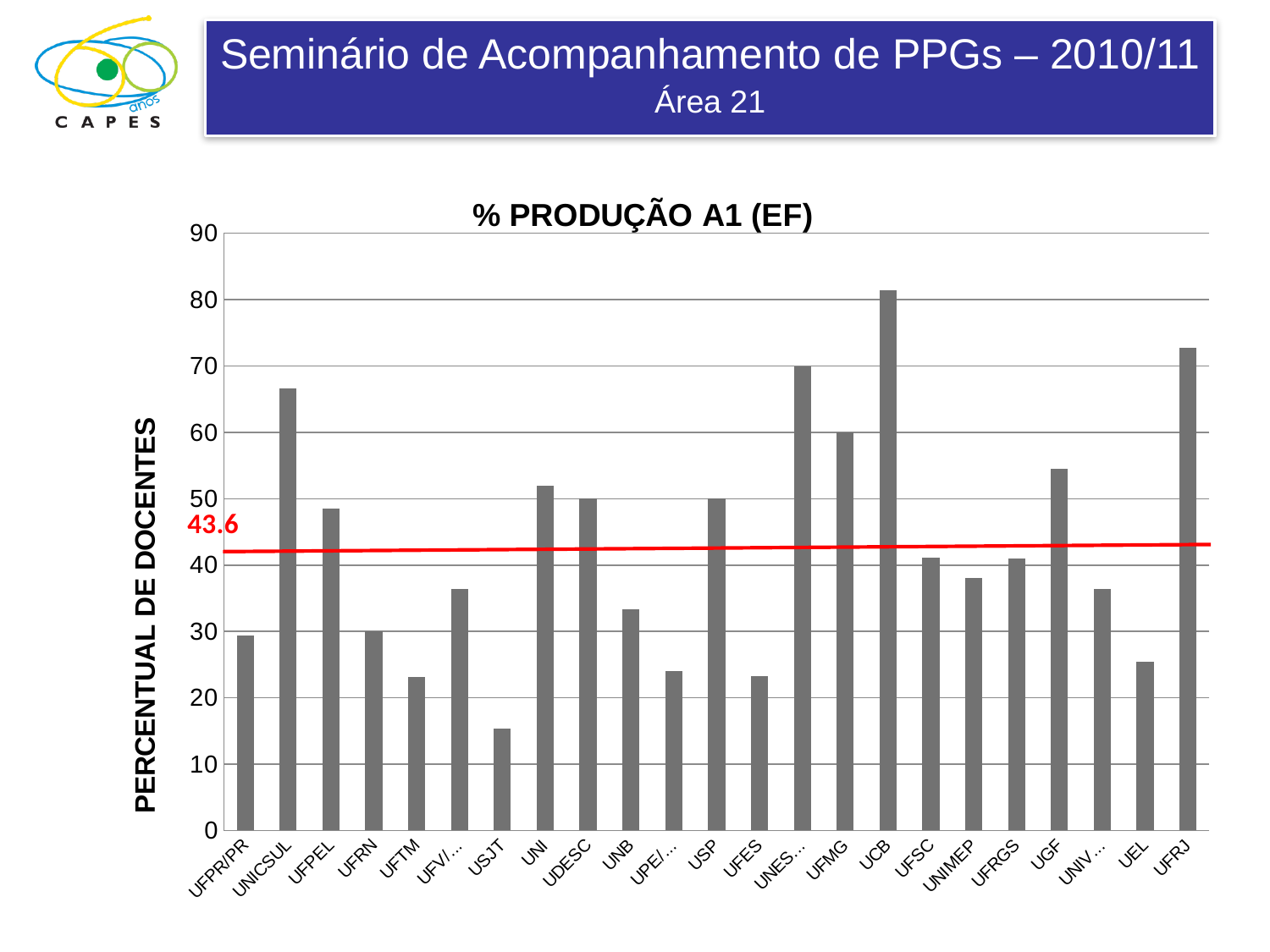
What type of chart is shown on the slide? bar chart Is the value for UNICSUL greater or less than 60? greater Is the value for UFRJ greater or less than 70? greater Which institution has the highest % PRODUÇÃO A1 (EF)? UCB Is the value for UCB greater or less than 80? greater What is the title of the vertical axis? PERCENTUAL DE DOCENTES Which institution has the lowest % PRODUÇÃO A1 (EF)? USJT What value is labelled on the red horizontal line in the chart? 43.6 How many institutions (bars) are shown in the chart? 23 Which has a higher value, UCB or UFRJ? UCB